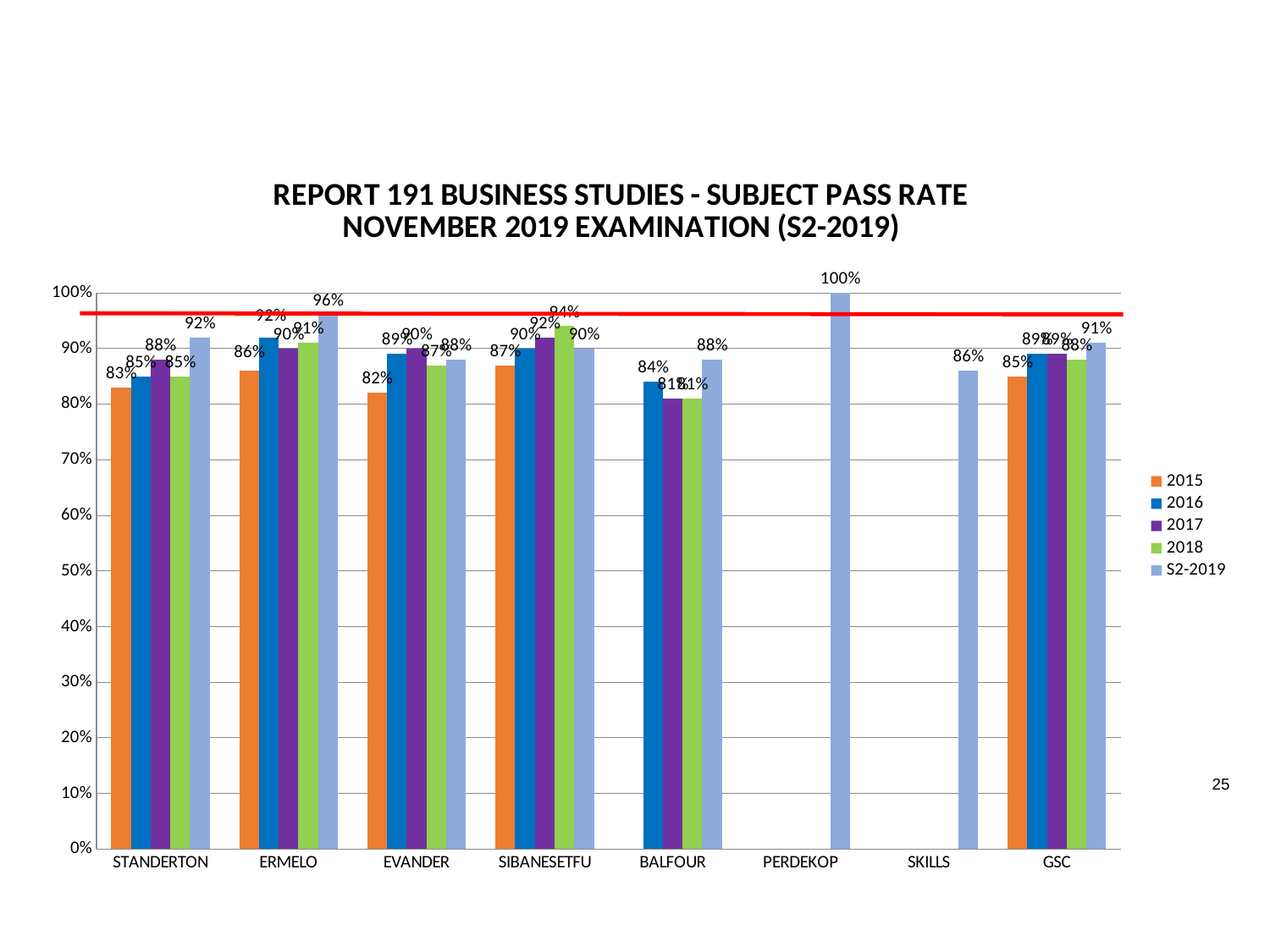
Which campus has the lowest 2015 pass rate? EVANDER Which campus has the highest S2-2019 pass rate? PERDEKOP What was the 2015 pass rate for STANDERTON? 83% What kind of chart is shown on the slide? Bar chart For BALFOUR, which is larger: the 2016 pass rate or the S2-2019 pass rate? S2-2019 By how many percentage points does STANDERTON's S2-2019 pass rate exceed its 2015 pass rate? 9 percentage points How many series does the legend list? 5 Which series is shown in orange in the legend? 2015 What is the S2-2019 pass rate for SKILLS? 86% What is the S2-2019 pass rate for ERMELO? 96% How many campuses (categories) are shown on the x axis? 8 What is the S2-2019 pass rate for PERDEKOP? 100%